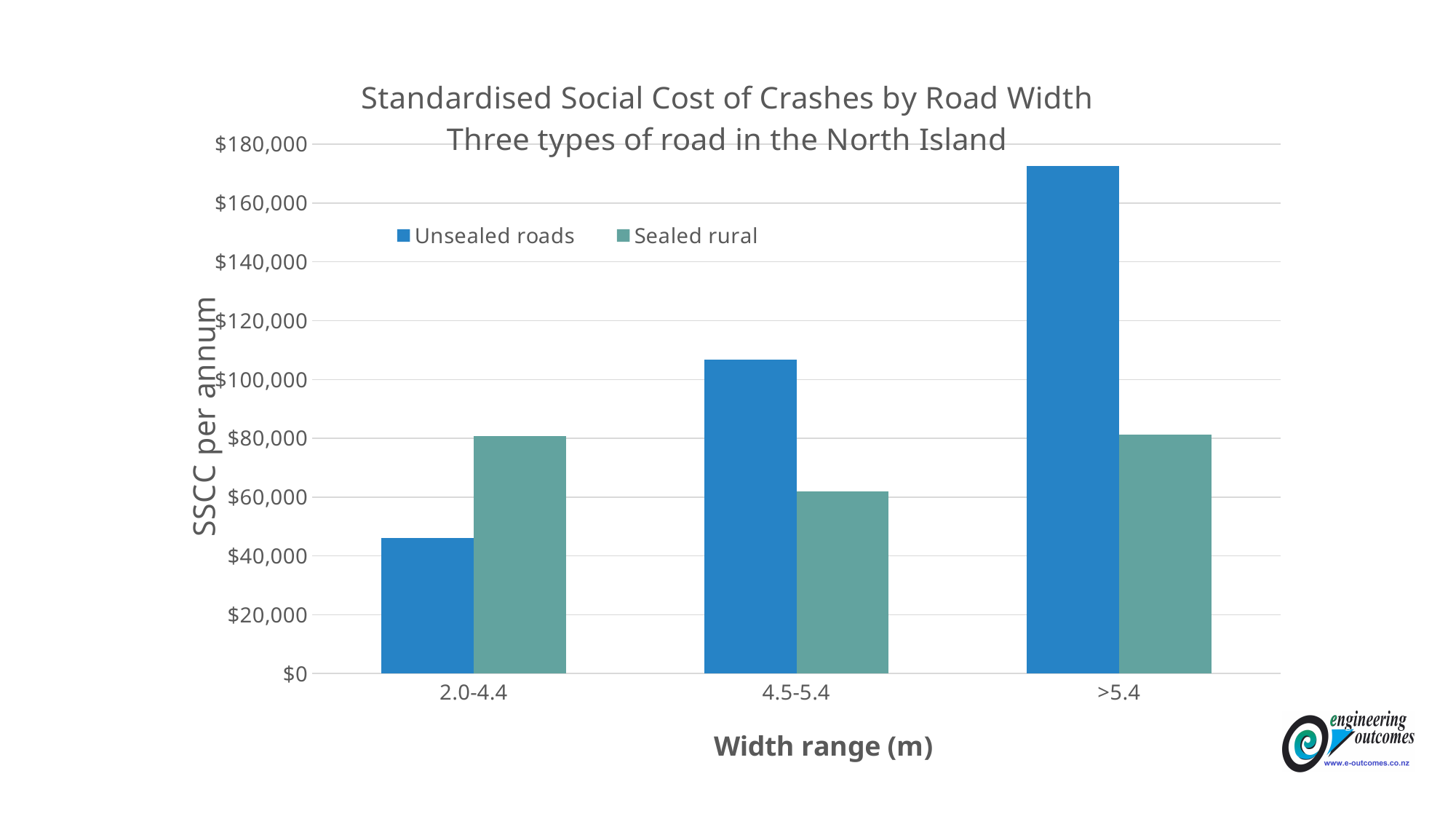
What kind of chart is shown on the slide? Bar chart How many series does the legend list? 2 Is the value for Sealed rural in the 4.5-5.4 width range greater or less than $80,000? less What is the title of the vertical axis? SSCC per annum Which width range has the highest value for Unsealed roads? >5.4 How many width range categories are shown on the x axis? 3 Is the value for Unsealed roads in the 2.0-4.4 width range greater or less than $60,000? less Which width range has the lowest value for Unsealed roads? 2.0-4.4 Do the values for Unsealed roads rise or fall as the width range increases along the x axis? Rise In the 2.0-4.4 width range, which series has the larger value, Unsealed roads or Sealed rural? Sealed rural Which width range has the lowest value for Sealed rural? 4.5-5.4 Is the value for Unsealed roads in the >5.4 width range greater or less than $160,000? greater